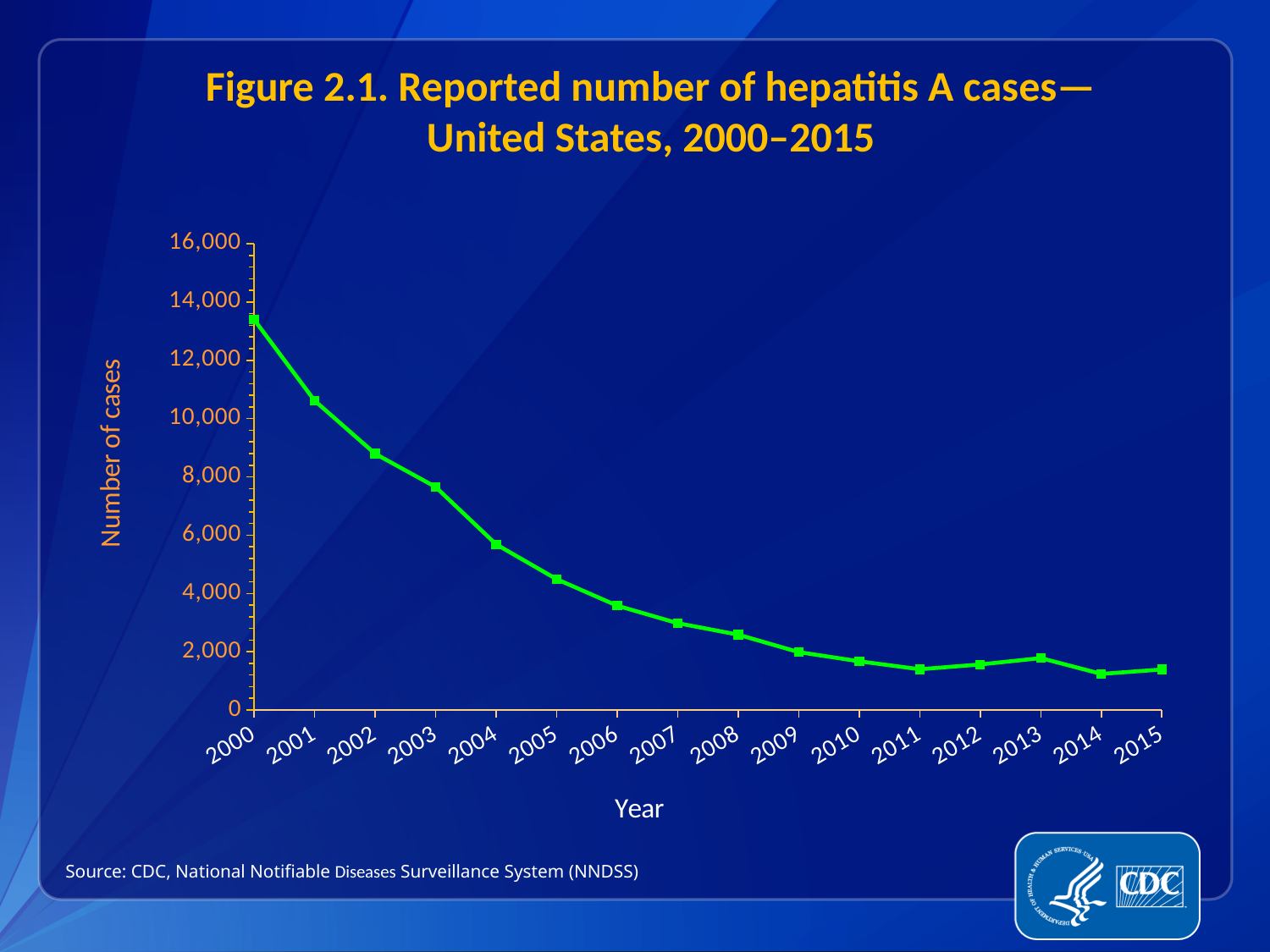
Is the number of cases in 2006 greater or less than 4,000? less Is the number of cases in 2014 greater or less than 2,000? less Which year has more reported cases, 2003 or 2008? 2003 How many years are plotted on the x axis? 16 Is the number of cases in 2003 greater or less than 8,000? less What kind of chart is shown on the slide? line chart What is the label on the y axis of the chart? Number of cases Which year has the highest reported number of hepatitis A cases? 2000 Do the reported hepatitis A cases generally rise or fall from 2000 to 2015? fall